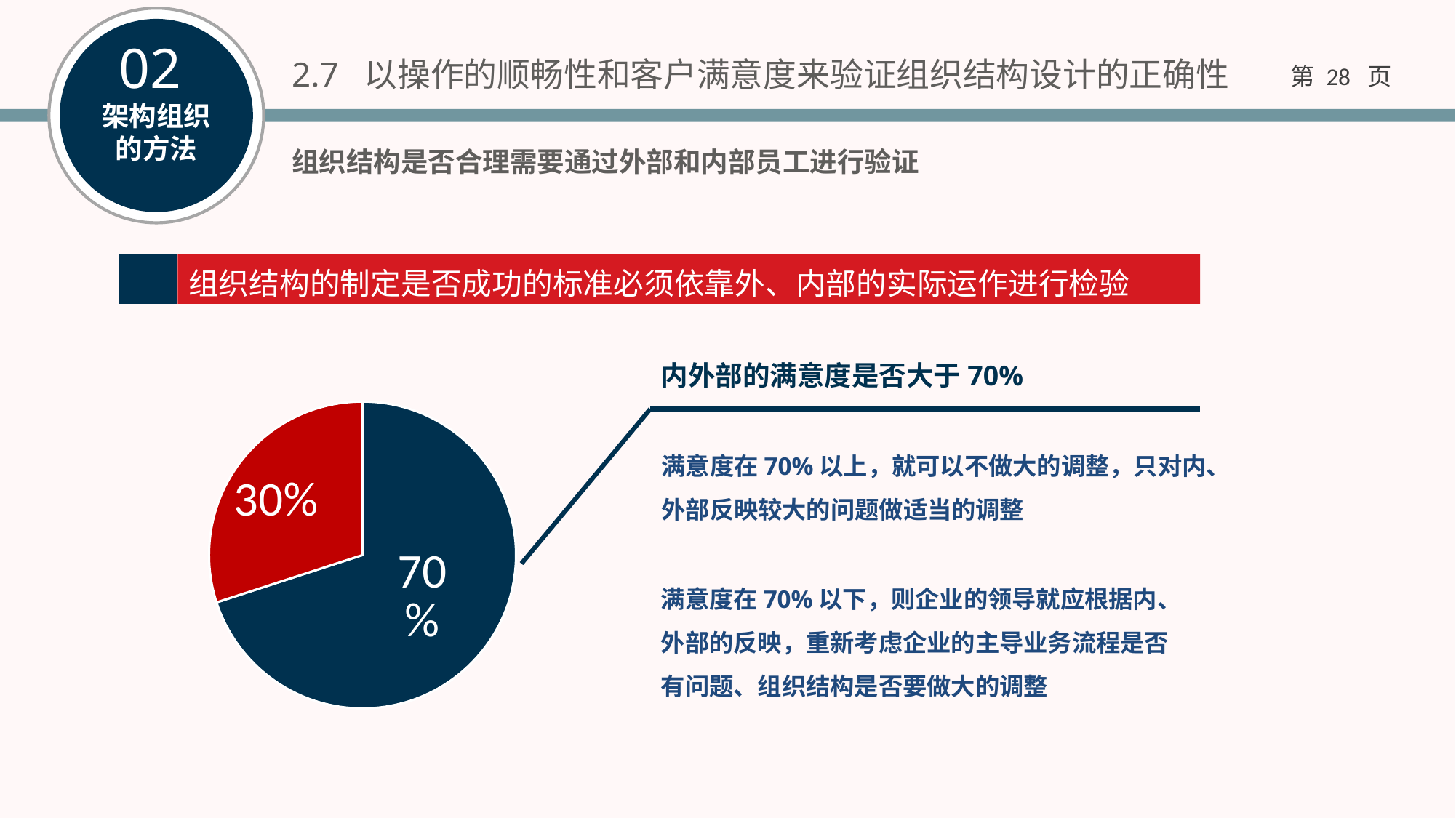
What colour is the 30% slice of the pie chart? red Which slice of the pie chart is the smallest? the red slice (30%) What share of the pie does the dark blue slice represent? 70% What percentage is shown on the red slice of the pie chart? 30% Which slice of the pie chart is the largest? the dark blue slice (70%) What is the heading text next to the pie chart that the connector line points to? 内外部的满意度是否大于 70% What percentage is shown on the dark blue slice of the pie chart? 70% What is the difference in percentage points between the dark blue slice and the red slice? 40 What share of the pie does the red slice represent? 30% What kind of chart is shown on the slide? pie chart How many slices does the pie chart have? 2 Which is larger in the pie chart, the red slice or the dark blue slice? the dark blue slice